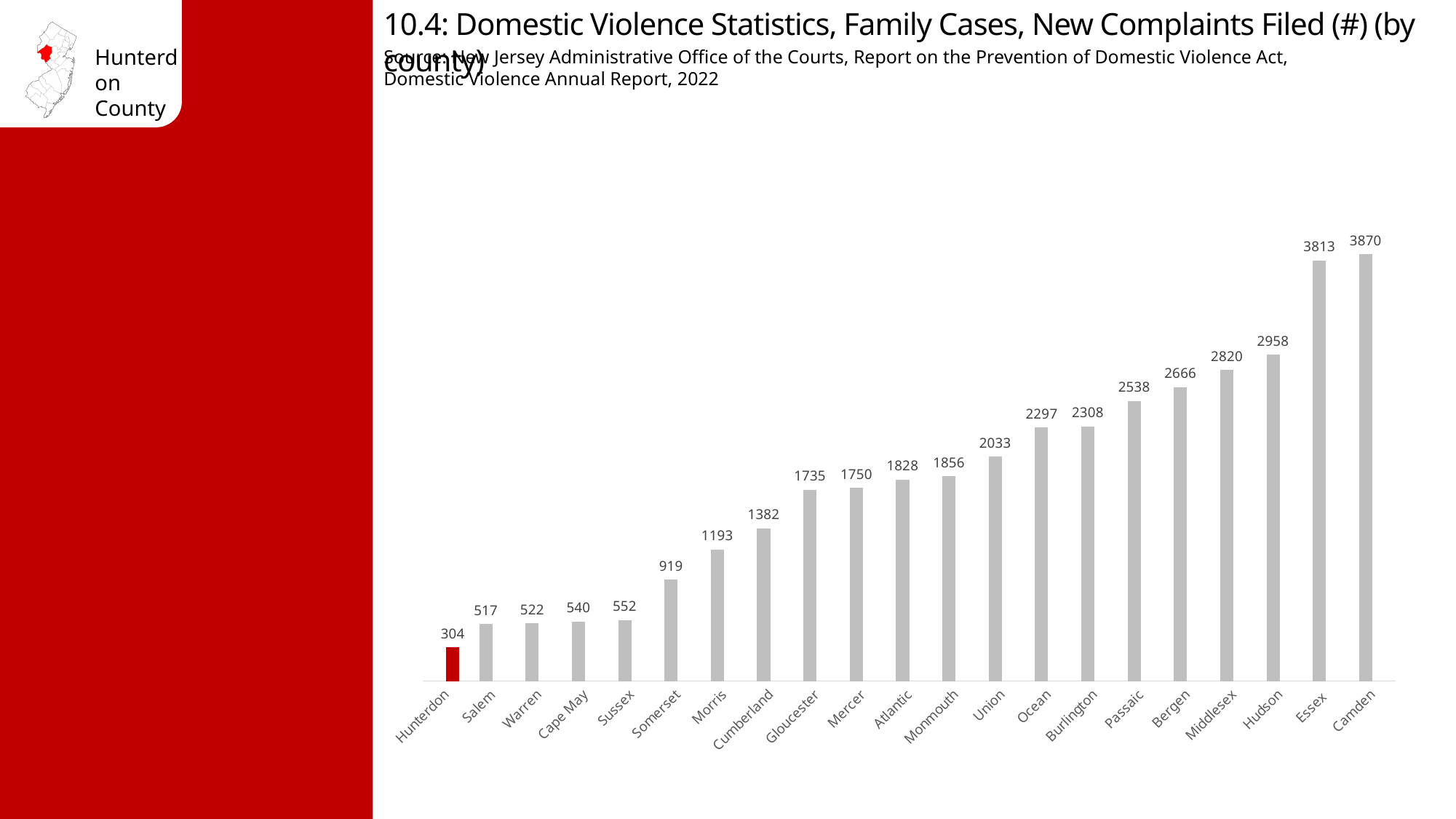
What is the difference between the values for Essex and Hunterdon? 3509 What is the value shown for Camden? 3870 What is the value shown for Morris? 1193 Which county has the lowest number of new complaints filed? Hunterdon Which county has the highest number of new complaints filed? Camden What kind of chart is shown on the slide? Bar chart How many counties are shown on the chart? 21 What is the number of new domestic violence complaints filed in Hunterdon County? 304 What is the difference between the values for Hudson and Middlesex? 138 What is the value shown for Bergen? 2666 Which bar is highlighted in red? Hunterdon Which has a larger value, Somerset or Cumberland? Cumberland